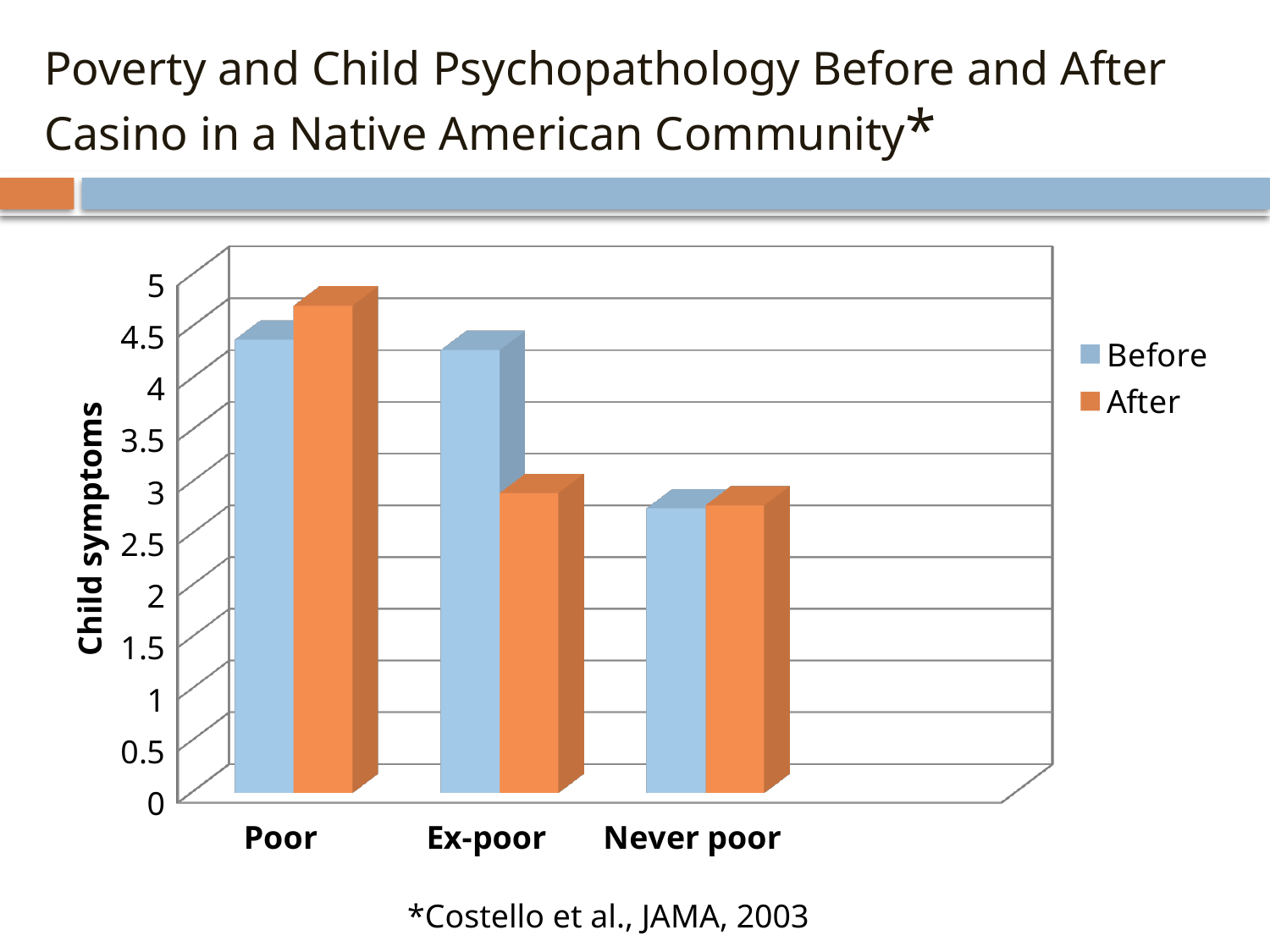
For Ex-poor, which is larger: the Before value or the After value? Before Which bar is the highest in the chart? Poor, After Is the Before value for Ex-poor greater or less than 4? greater How many series does the legend list? 2 How many categories are shown on the x axis? 3 What kind of chart is shown on the slide? bar chart What is the label of the vertical axis? Child symptoms Is the After value for Ex-poor greater or less than 3.5? less Within the After series, which category has the highest value? Poor For Poor, which is larger: the Before value or the After value? After Within the Before series, which category has the lowest value? Never poor Which series is shown in orange? After